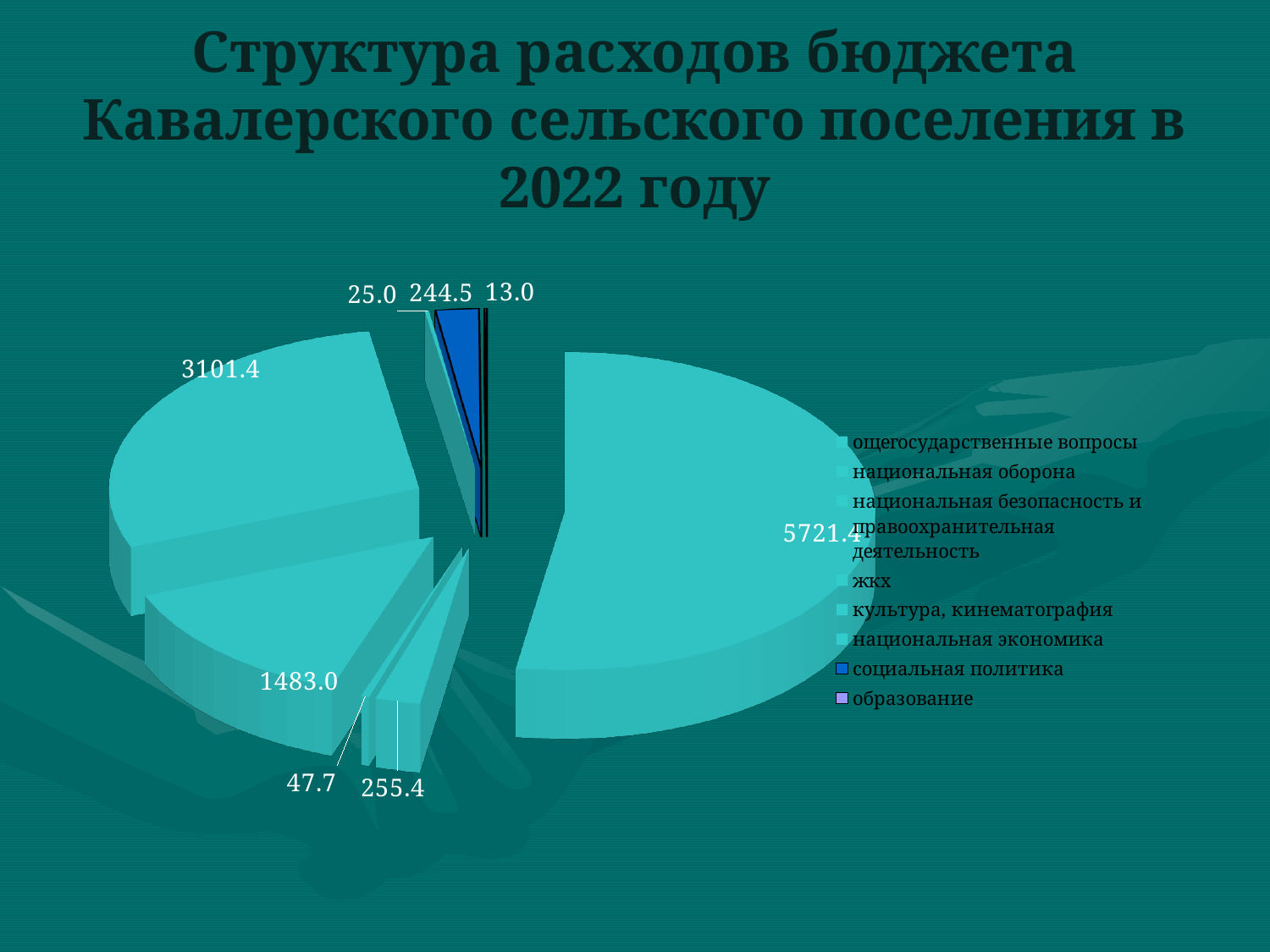
How many entries does the legend of the pie chart list? 8 What is the total of all the values labelled on the pie chart? 10891.4 How many slices does the pie chart have? 8 Which legend entry is listed last in the pie chart's legend? образование What is the difference between the two largest slice values, 5721.4 and 3101.4? 2620.0 What is the difference between the slice values 1483.0 and 255.4? 1227.6 Which is larger, the slice labelled 244.5 or the slice labelled 255.4? 255.4 Which is larger, the slice labelled 47.7 or the slice labelled 25.0? 47.7 What is the smallest value labelled on the pie chart? 13.0 What type of chart is shown on the slide? pie chart What is the largest value labelled on the pie chart? 5721.4 What year does the chart title say the budget expenditure structure refers to? 2022